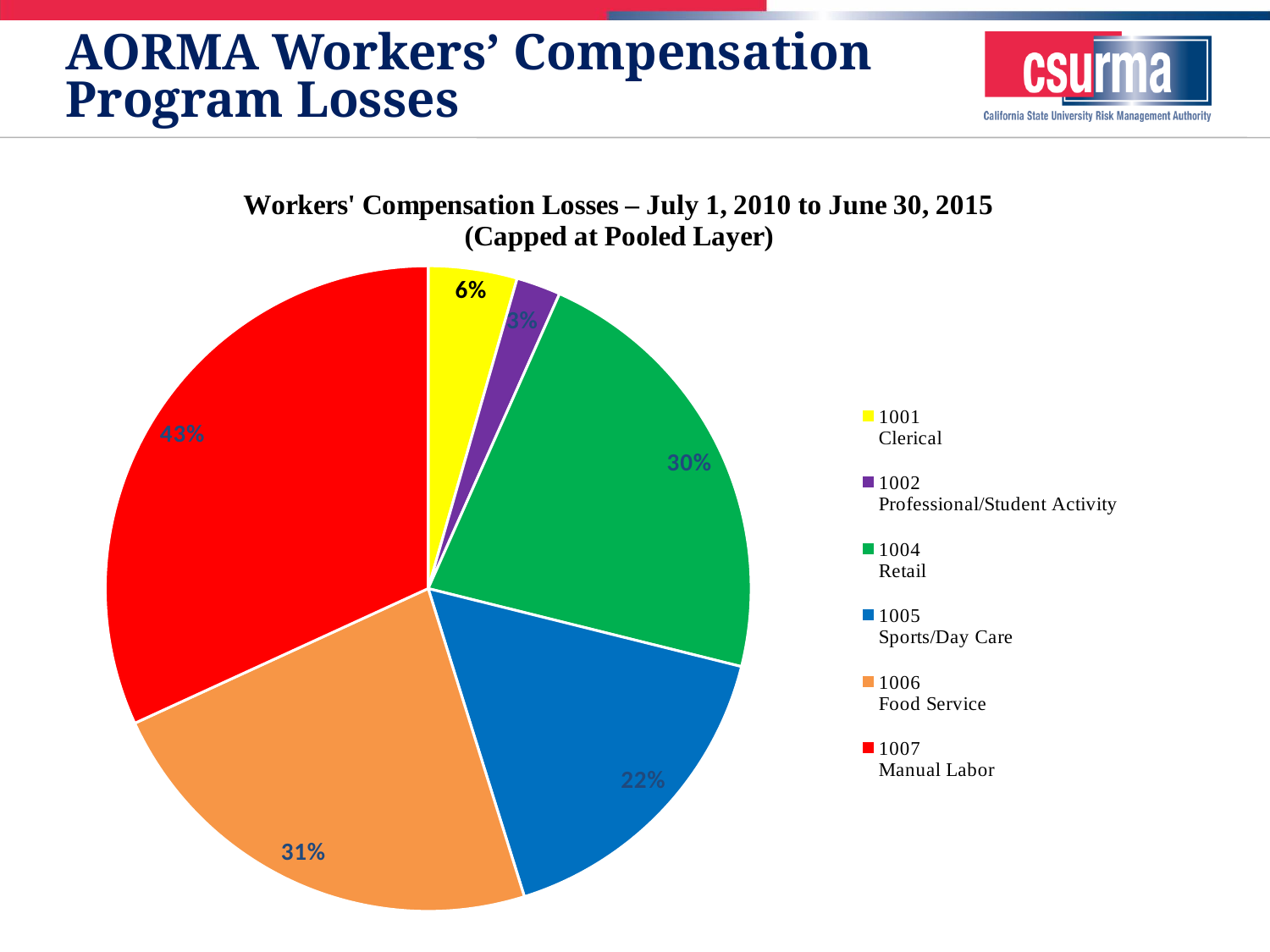
What is the title of the chart? Workers' Compensation Losses – July 1, 2010 to June 30, 2015 (Capped at Pooled Layer) What percentage is shown for 1001 Clerical? 6% What percentage is shown for 1004 Retail? 30% Which category has the smallest slice of the pie? 1002 Professional/Student Activity How many slices does the pie chart have? 6 What percentage is shown for 1005 Sports/Day Care? 22% Which colour represents 1004 Retail in the pie chart? Green Which category has the largest slice of the pie? 1007 Manual Labor What percentage is shown for 1007 Manual Labor? 43% What percentage is shown for 1006 Food Service? 31% What is the difference between the percentages shown for 1007 Manual Labor and 1005 Sports/Day Care? 21% What kind of chart is shown on the slide? Pie chart